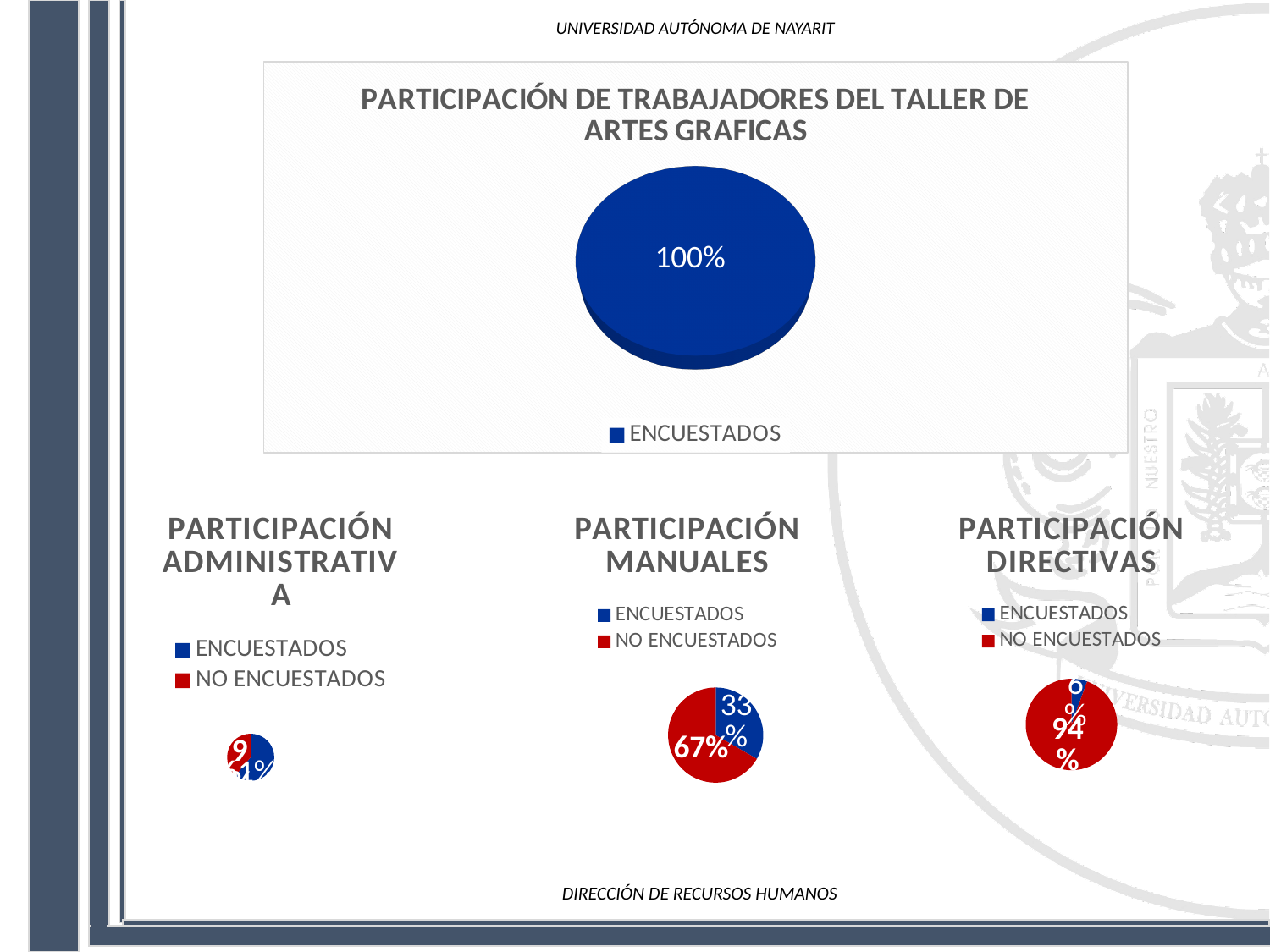
In the 'PARTICIPACIÓN DIRECTIVAS' chart, which category has the smallest slice? ENCUESTADOS In the 'PARTICIPACIÓN MANUALES' chart, which slice is larger, ENCUESTADOS or NO ENCUESTADOS? NO ENCUESTADOS In the 'PARTICIPACIÓN DIRECTIVAS' chart, what share is shown for ENCUESTADOS? 6% How many legend entries does the 'PARTICIPACIÓN ADMINISTRATIVA' chart list? 2 In the 'PARTICIPACIÓN MANUALES' chart, what share is shown for NO ENCUESTADOS? 67% In the 'PARTICIPACIÓN DIRECTIVAS' chart, what colour represents NO ENCUESTADOS? Red In the 'PARTICIPACIÓN DIRECTIVAS' chart, what share is shown for NO ENCUESTADOS? 94% In the 'PARTICIPACIÓN MANUALES' chart, what is the difference between the NO ENCUESTADOS and ENCUESTADOS shares? 34% How many series does the legend of the 'PARTICIPACIÓN DE TRABAJADORES DEL TALLER DE ARTES GRAFICAS' chart list? 1 In the chart titled 'PARTICIPACIÓN DE TRABAJADORES DEL TALLER DE ARTES GRAFICAS', what percentage is shown for ENCUESTADOS? 100% What kind of chart is the 'PARTICIPACIÓN DE TRABAJADORES DEL TALLER DE ARTES GRAFICAS' chart? Pie chart